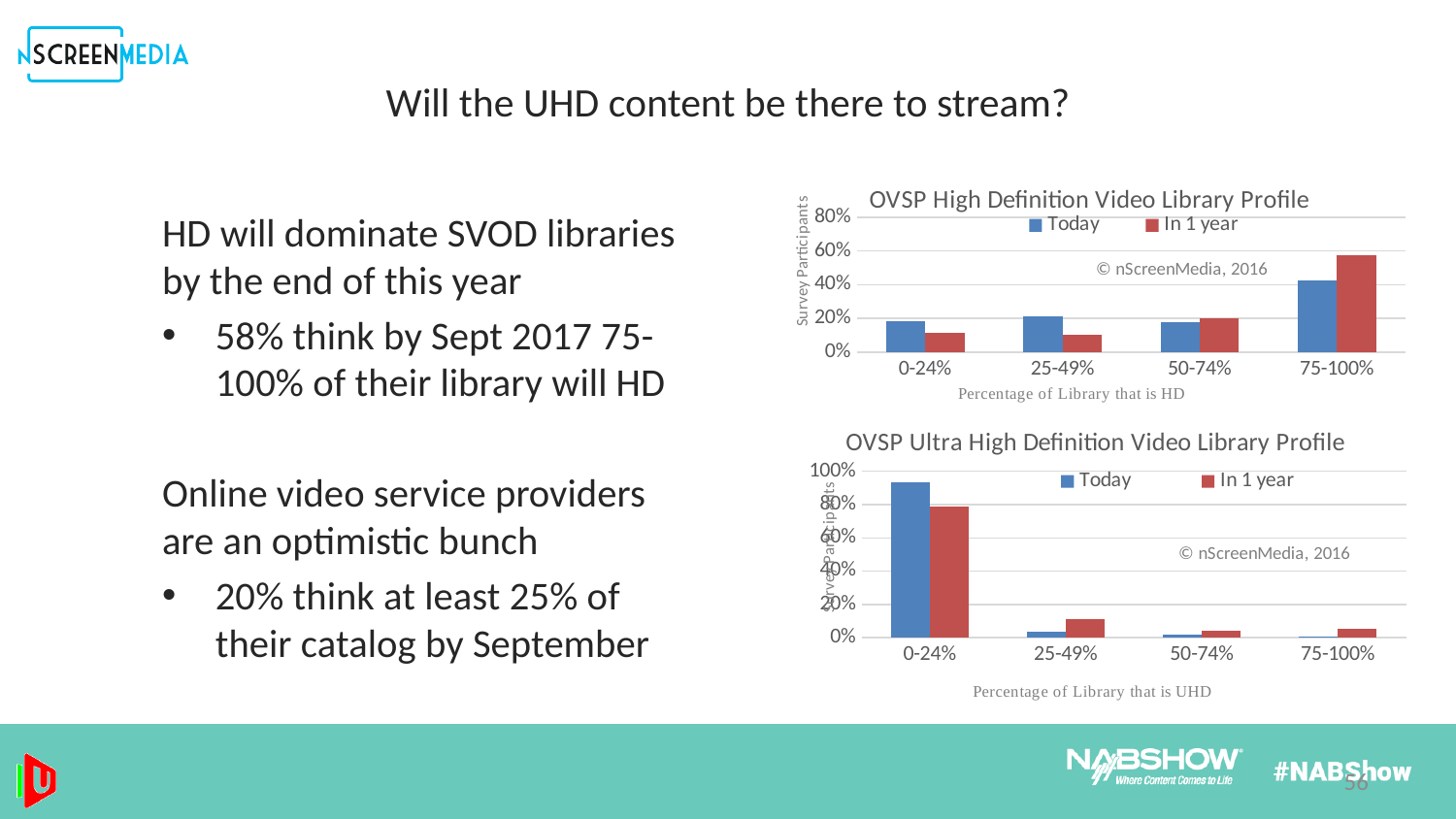
In the 'OVSP High Definition Video Library Profile' chart, which category has the lowest 'In 1 year' value? 25-49% In the 'OVSP Ultra High Definition Video Library Profile' chart, is the 'In 1 year' value for 25-49% greater or less than 20%? less In the 'OVSP Ultra High Definition Video Library Profile' chart, which category has the highest 'Today' value? 0-24% In the 'OVSP High Definition Video Library Profile' chart, is the 'In 1 year' value for 75-100% greater or less than 40%? greater How many series does the legend of the 'OVSP Ultra High Definition Video Library Profile' chart list? 2 In the 'OVSP High Definition Video Library Profile' chart, which category has the highest 'In 1 year' value? 75-100% What kind of chart is the 'OVSP High Definition Video Library Profile' chart? bar chart In the 'OVSP Ultra High Definition Video Library Profile' chart, is the 'Today' value for 0-24% greater or less than 80%? greater In the 'OVSP High Definition Video Library Profile' chart, for the 75-100% category, which is larger: 'Today' or 'In 1 year'? In 1 year What is the x axis label of the 'OVSP Ultra High Definition Video Library Profile' chart? Percentage of Library that is UHD In the 'OVSP Ultra High Definition Video Library Profile' chart, for the 0-24% category, which is larger: 'Today' or 'In 1 year'? Today How many categories are shown on the x axis of the 'OVSP High Definition Video Library Profile' chart? 4